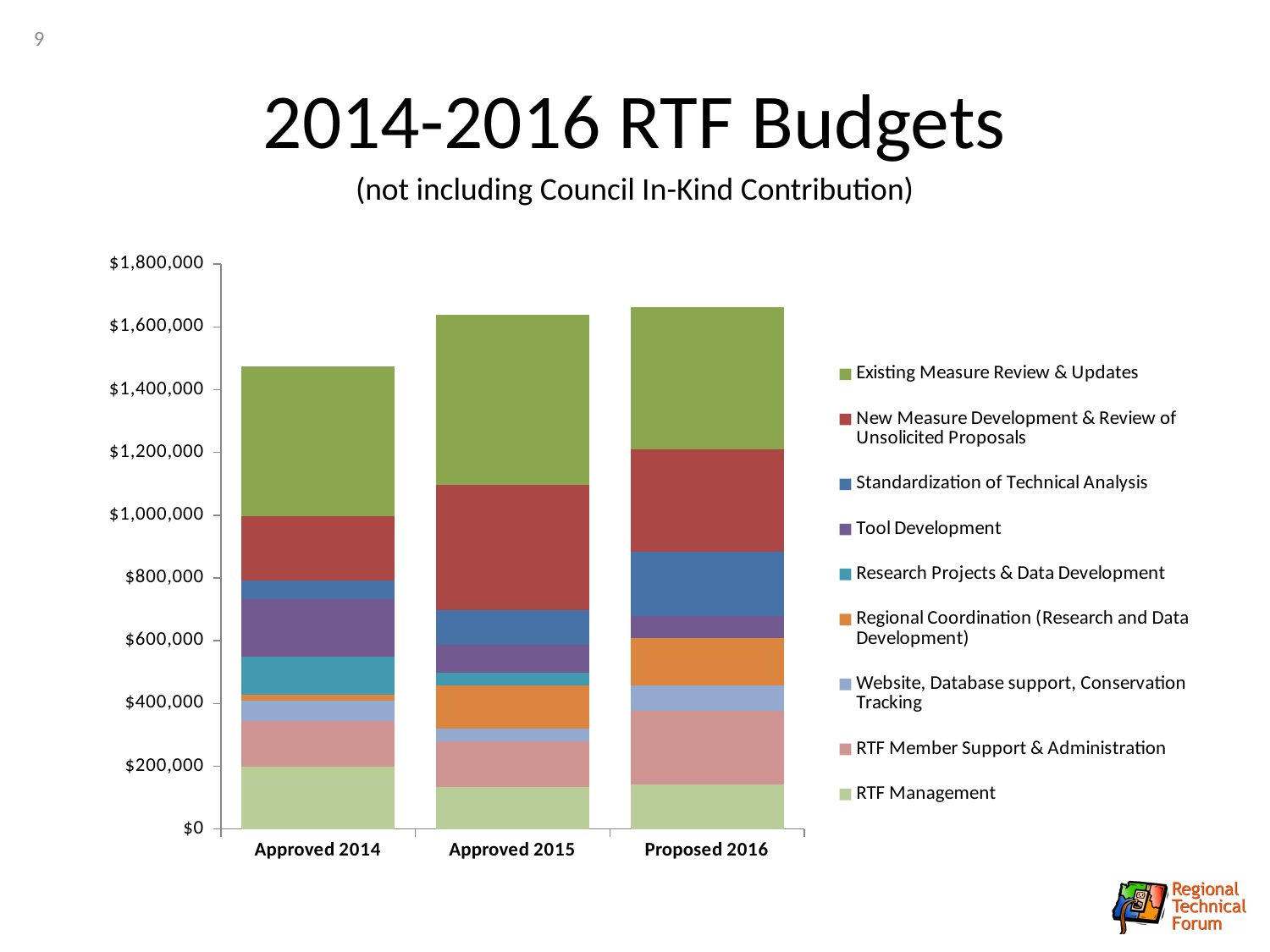
Is the total for Approved 2014 greater or less than $1,400,000? greater Is the total for Proposed 2016 greater or less than $1,600,000? greater What kind of chart is shown on the slide? Stacked bar chart Is the total for Approved 2015 greater or less than $1,400,000? greater How many budget years (categories) are shown on the x axis? 3 Do the total budgets rise or fall from Approved 2014 to Proposed 2016? rise What is the title of the chart slide? 2014-2016 RTF Budgets Which series is listed first (at the top) in the legend? Existing Measure Review & Updates Which total is larger, Approved 2014 or Proposed 2016? Proposed 2016 Which budget year has the lowest total bar? Approved 2014 How many series does the legend list? 9